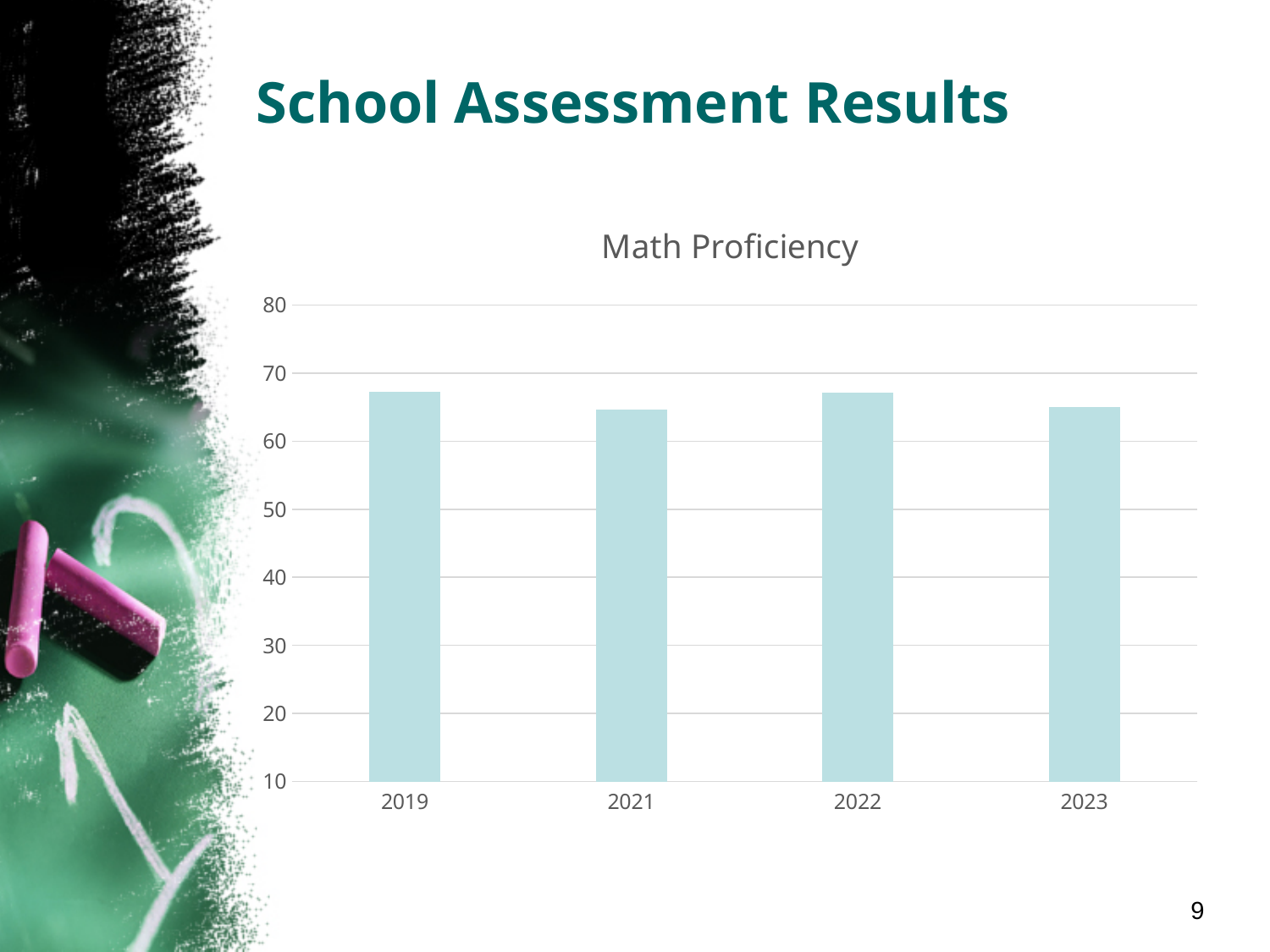
Is the value for 2019 greater or less than 70? less Is the value for 2023 greater or less than 60? greater Is the value for 2022 greater or less than 70? less What is the title of the chart? Math Proficiency What kind of chart is shown on the slide? bar chart How many years are shown on the x axis of the chart? 4 What is the lowest value shown on the vertical axis of the chart? 10 Which year is the first category on the x axis of the chart? 2019